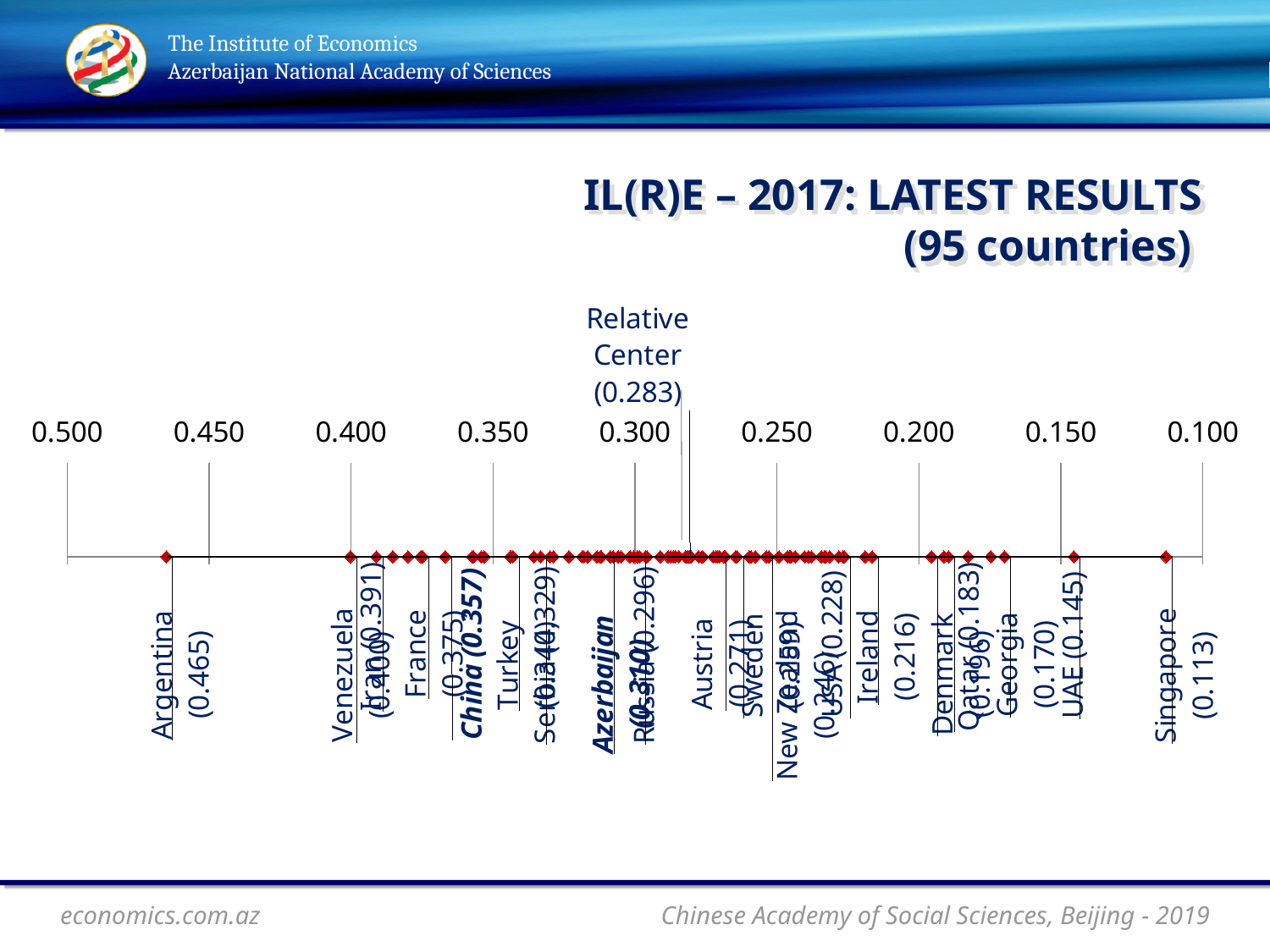
What is the difference between the values for China and Azerbaijan? 0.047 What is the IL(R)E value shown for Singapore? 0.113 What value is shown for Ireland? 0.216 Which has the higher value, China or Azerbaijan? China What value is shown for UAE? 0.145 What value is shown for China? 0.357 Which labeled country has the lowest value on the chart? Singapore What is the difference between the values for Argentina and Singapore? 0.352 Which labeled country has the highest value on the chart? Argentina What value is given for the Relative Center? 0.283 What is the IL(R)E value shown for Argentina? 0.465 What value is shown for Azerbaijan? 0.310